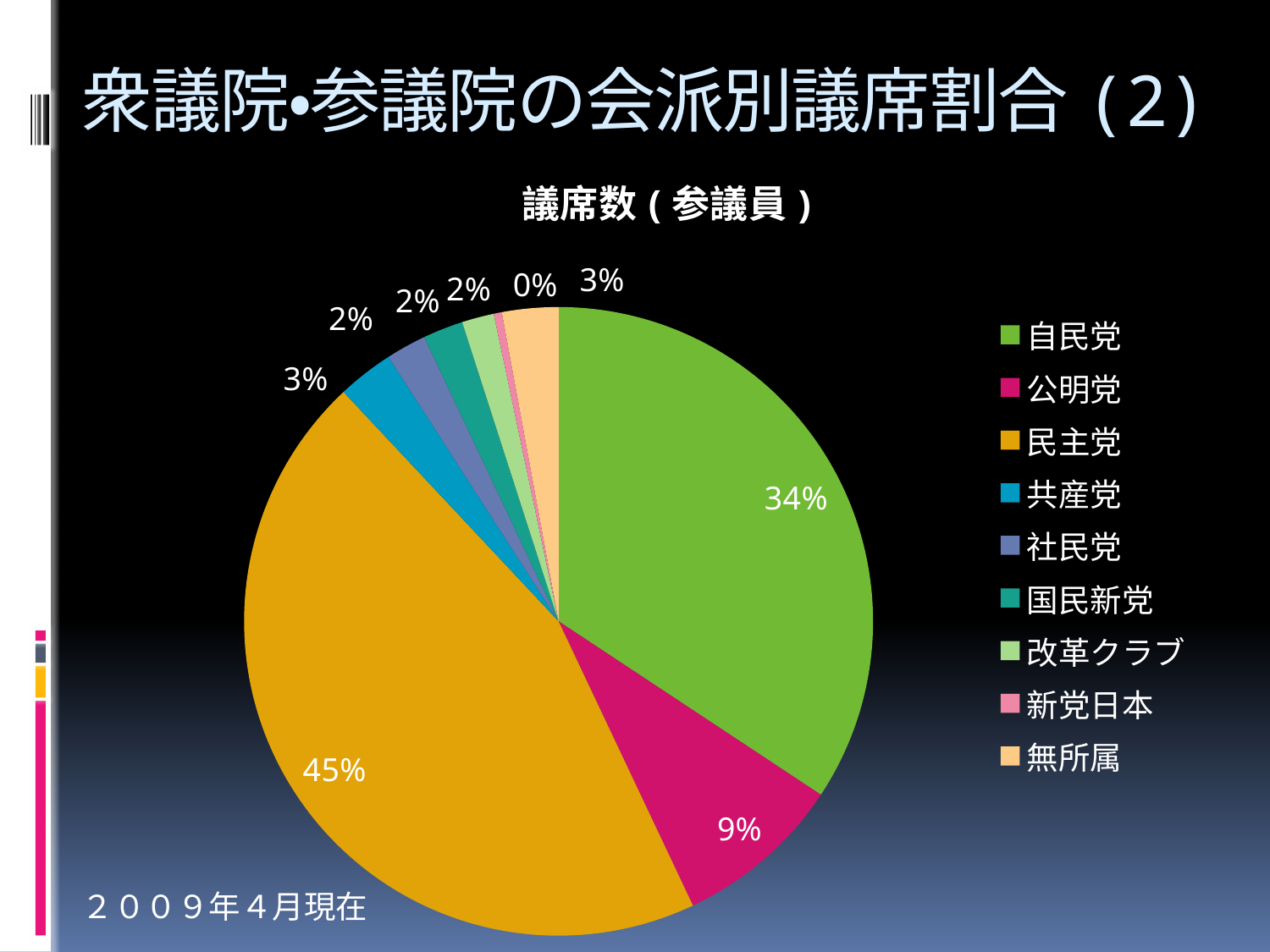
Which party has the largest share of seats? 民主党 What share of the pie does 公明党 hold? 9% How many parties (categories) does the legend list? 9 What share of the pie does 新党日本 hold? 0% What share of the pie does 自民党 hold? 34% What is the difference in percentage points between 民主党 and 自民党? 11 Which party has the smallest share of seats? 新党日本 What kind of chart is shown on the slide? pie chart Which has a larger share, 公明党 or 無所属? 公明党 What is the title of the chart? 議席数（参議員）